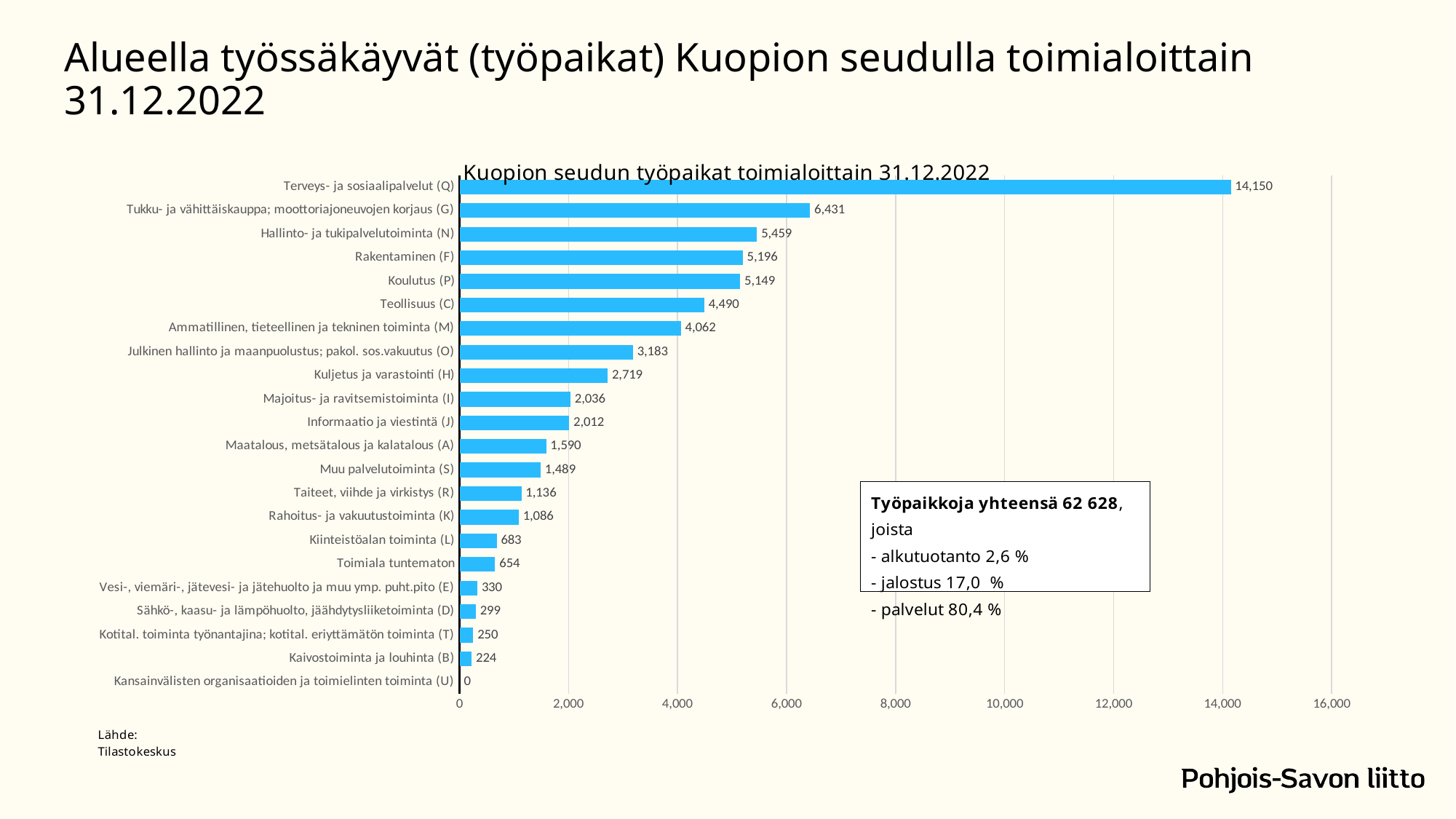
How many categories are shown in the chart? 22 Which category has the highest value? Terveys- ja sosiaalipalvelut (Q) Is the value for Julkinen hallinto ja maanpuolustus; pakol. sos.vakuutus (O) greater or less than 4,000? less What is the value for Rakentaminen (F)? 5,196 What is the value for Kuljetus ja varastointi (H)? 2,719 What is the difference between the values for Tukku- ja vähittäiskauppa; moottoriajoneuvojen korjaus (G) and Hallinto- ja tukipalvelutoiminta (N)? 972 What is the title of the chart? Kuopion seudun työpaikat toimialoittain 31.12.2022 What is the value for Terveys- ja sosiaalipalvelut (Q)? 14,150 Which category has the lowest value? Kansainvälisten organisaatioiden ja toimielinten toiminta (U) What is the value for Kaivostoiminta ja louhinta (B)? 224 Which is larger, the value for Teollisuus (C) or the value for Ammatillinen, tieteellinen ja tekninen toiminta (M)? Teollisuus (C) What kind of chart is shown on the slide? bar chart